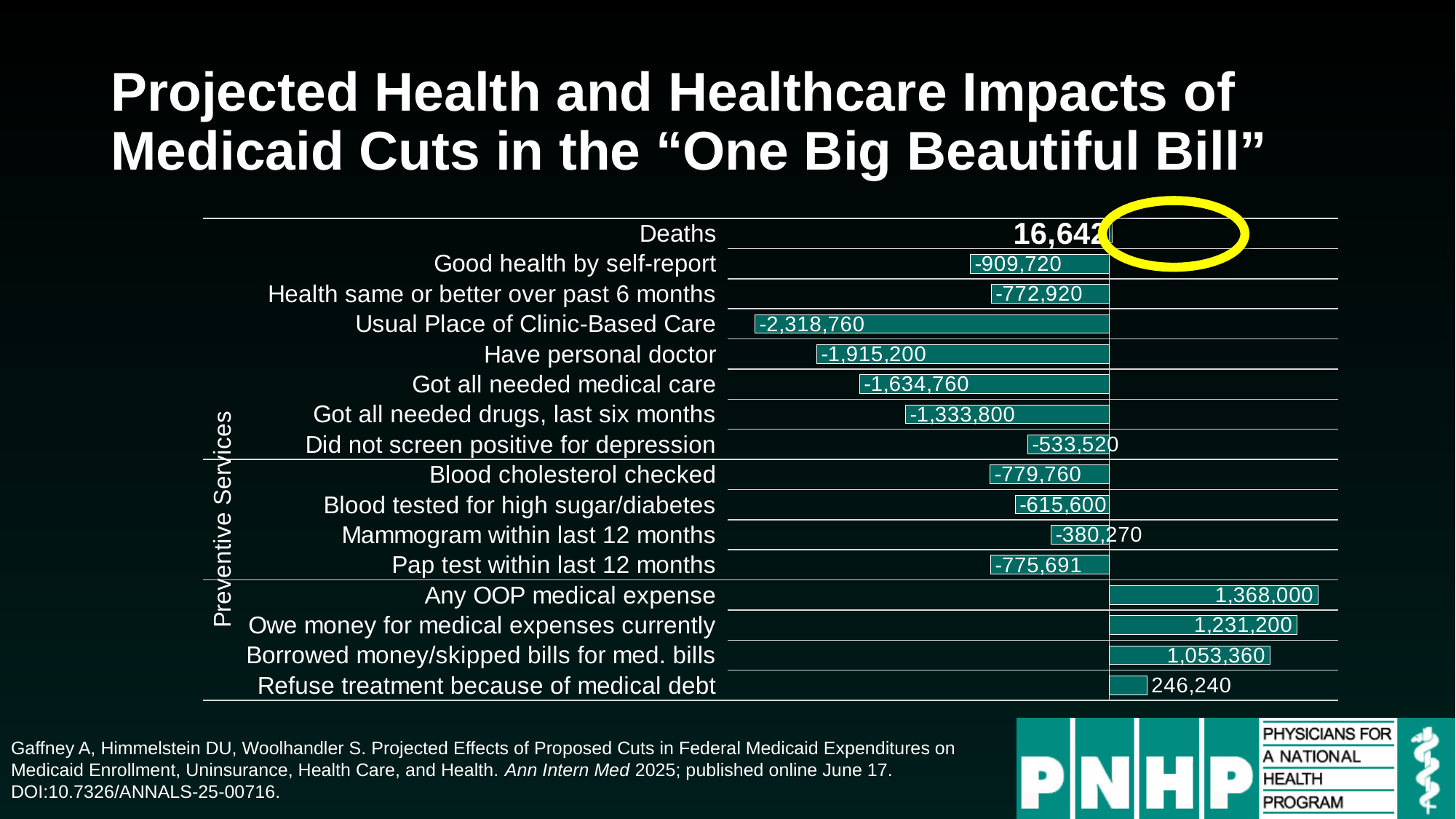
What is the projected value for Usual Place of Clinic-Based Care? -2,318,760 What is the difference between the values for Have personal doctor and Got all needed medical care? 280,440 Which category has the highest positive value? Any OOP medical expense What is the projected value for Mammogram within last 12 months? -380,270 What kind of chart is shown on the slide? Bar chart How many categories are plotted in the chart? 16 Which category has the largest negative value (the longest bar to the left)? Usual Place of Clinic-Based Care What is the projected value for Any OOP medical expense? 1,368,000 What is the difference between the values for Any OOP medical expense and Owe money for medical expenses currently? 136,800 Which shows a larger decline, Good health by self-report or Health same or better over past 6 months? Good health by self-report What group label is written vertically along the left side of the chart? Preventive Services What is the projected value for Refuse treatment because of medical debt? 246,240